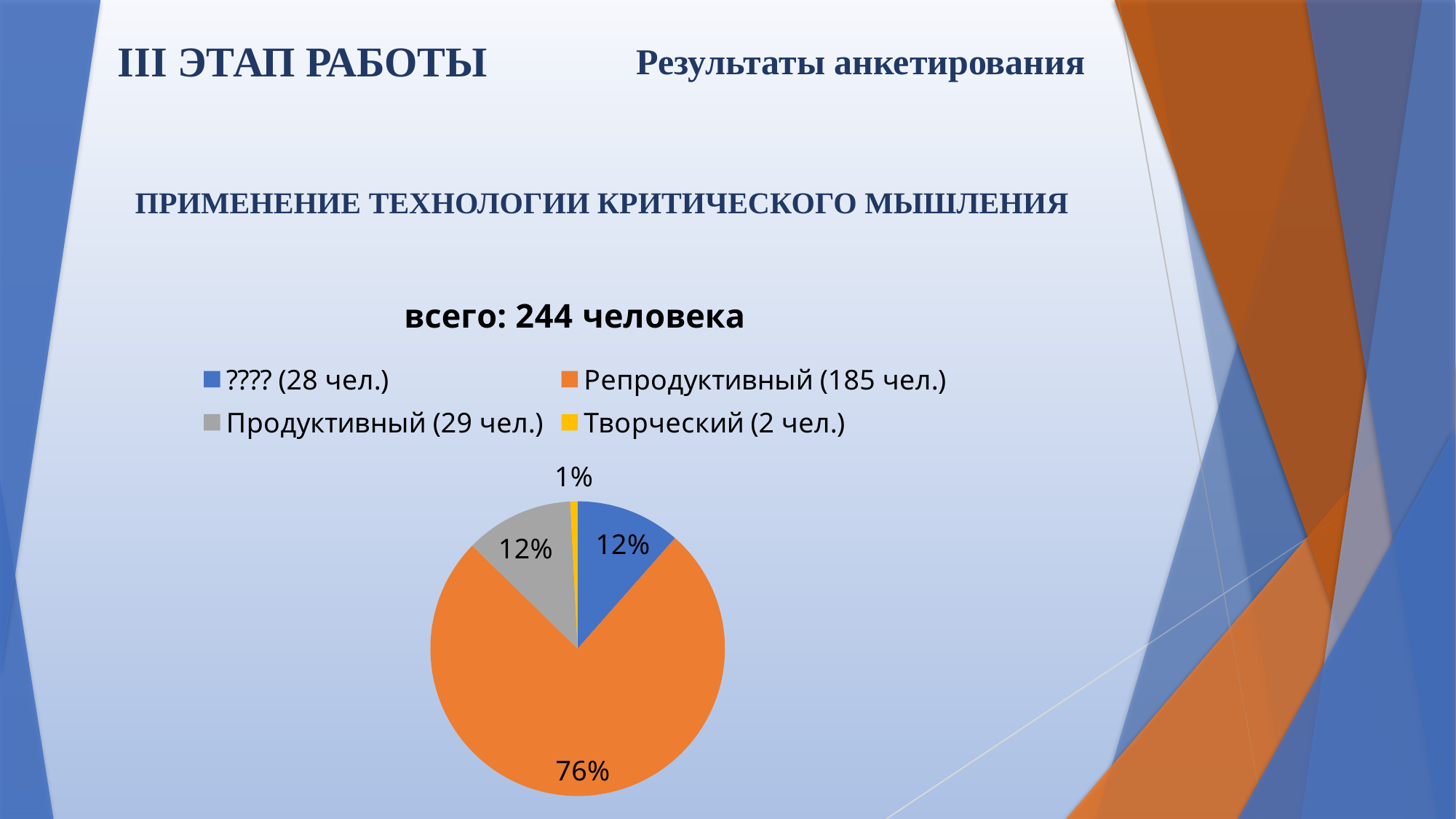
What share of the pie does Продуктивный take? 12% How many slices does the pie chart have? 4 What share of the pie does Творческий take? 1% Which is larger, the slice for Репродуктивный or the slice for Продуктивный? Репродуктивный What kind of chart is shown on the slide? pie chart What is the title of the pie chart? всего: 244 человека What share of the pie does Репродуктивный take? 76% What is the difference in percentage points between the Репродуктивный slice and the Творческий slice? 75% What is the difference in percentage points between the Репродуктивный slice and the Продуктивный slice? 64% According to the legend, how many people are in the Репродуктивный category? 185 чел. Which category has the smallest slice of the pie? Творческий Which category has the largest slice of the pie? Репродуктивный